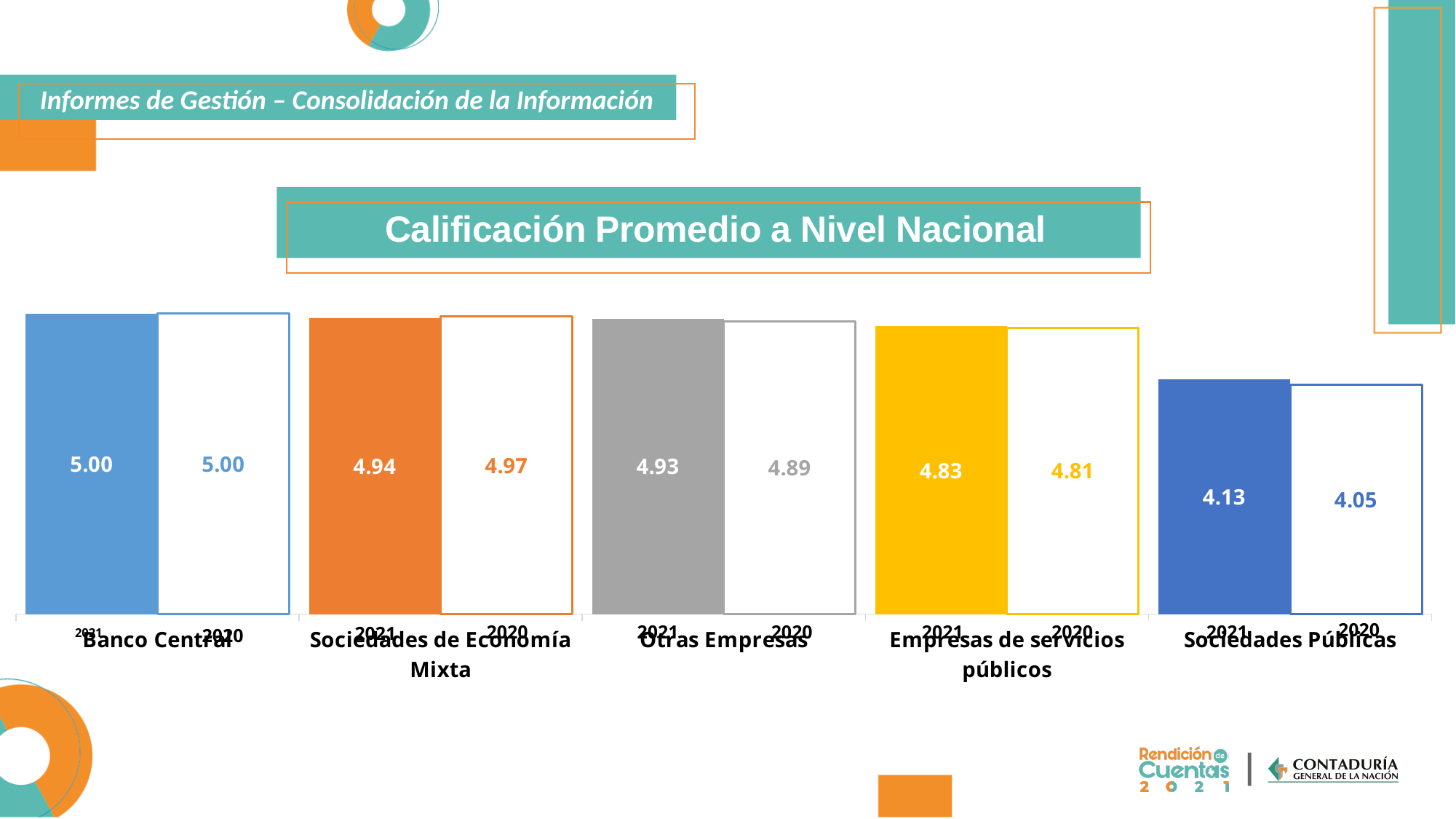
What is the title of the chart? Calificación Promedio a Nivel Nacional How many categories are shown on the x axis? 5 What is the 2021 value for Sociedades de Economía Mixta? 4.94 Which category has the lowest 2021 value? Sociedades Públicas Which category has the highest 2020 value? Banco Central What is the difference between the 2020 and 2021 values for Sociedades de Economía Mixta? 0.03 What is the 2020 value for Otras Empresas? 4.89 What is the 2021 value for Sociedades Públicas? 4.13 Which is larger for Otras Empresas, the 2021 value or the 2020 value? 2021 What is the difference between the 2021 and 2020 values for Sociedades Públicas? 0.08 What is the 2020 value for Empresas de servicios públicos? 4.81 What kind of chart is shown on the slide? Bar chart